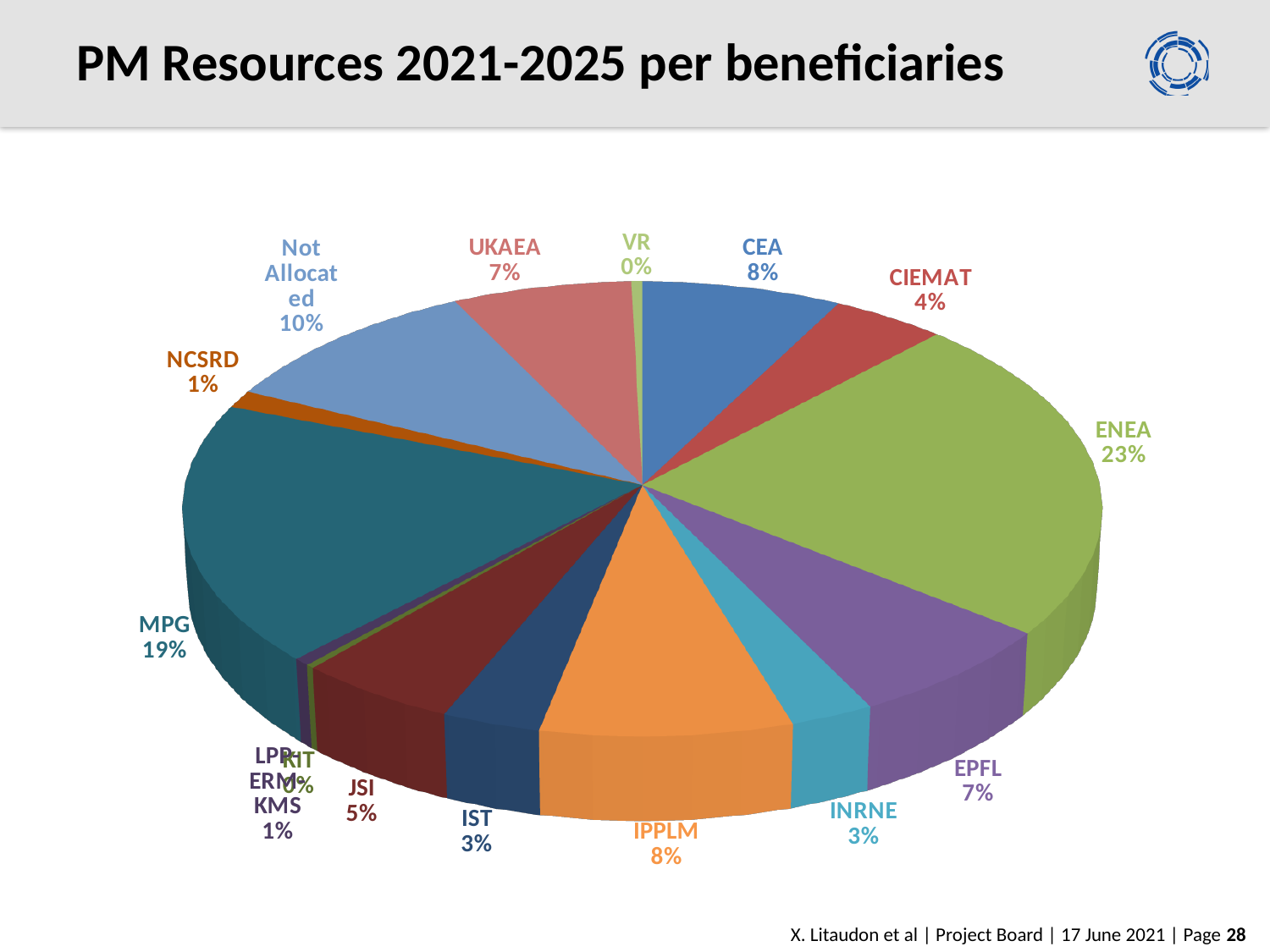
What is the combined share of CEA and CIEMAT? 12% Which beneficiary has the largest share of PM resources? ENEA What percentage is shown for the 'Not Allocated' slice? 10% Which has a larger share, UKAEA or CIEMAT? UKAEA What is the title of the chart on the slide? PM Resources 2021-2025 per beneficiaries Which has a larger share, JSI or IST? JSI What share of PM resources is allocated to ENEA? 23% What is the difference in percentage points between ENEA and MPG? 4 What share of PM resources is allocated to MPG? 19% What share is shown for IPPLM? 8% What kind of chart is shown on the slide? pie chart What share is shown for VR? 0%